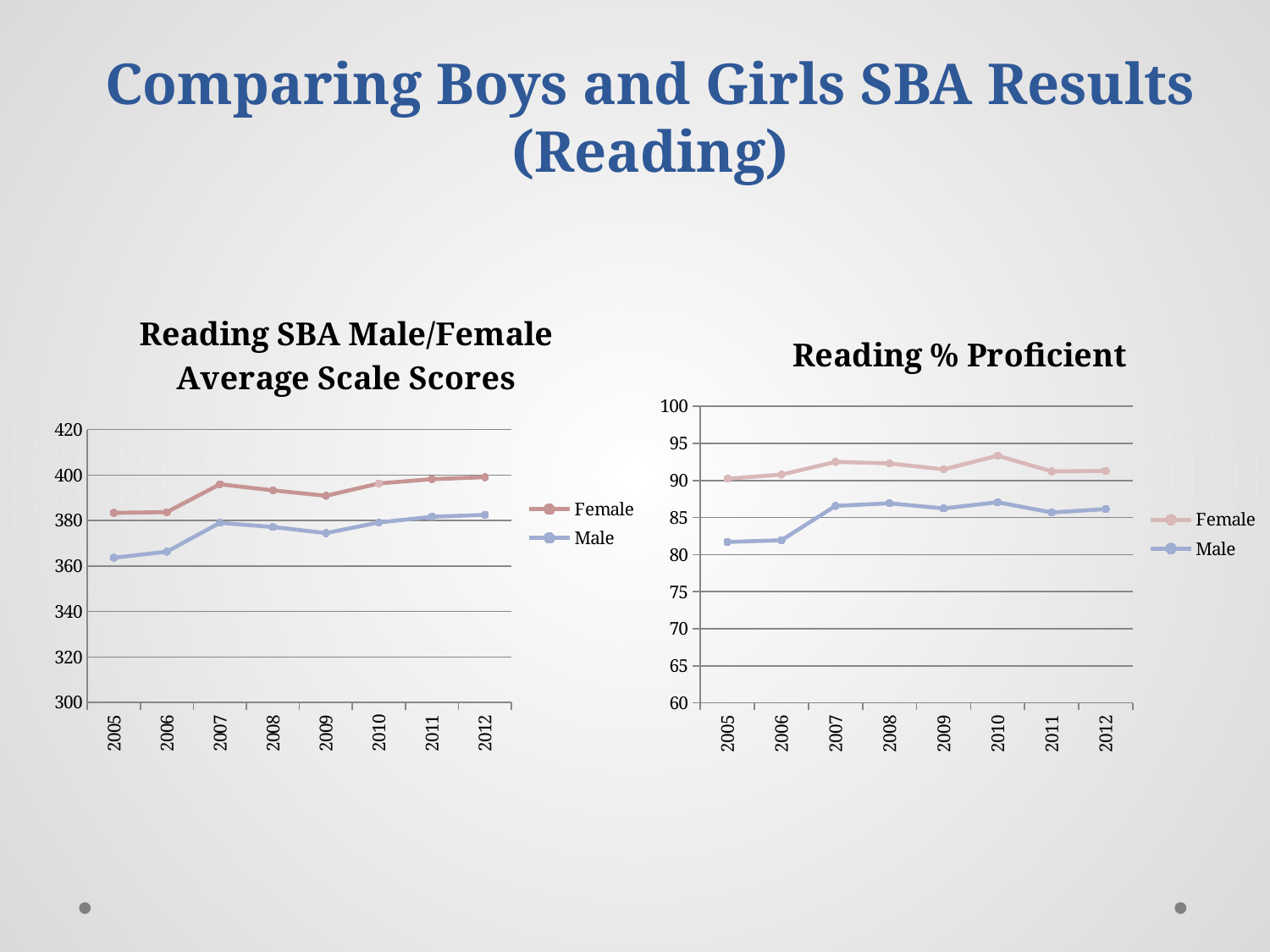
What kind of chart is the 'Reading SBA Male/Female Average Scale Scores' chart on the left? line chart How many years are plotted along the x axis of the 'Reading SBA Male/Female Average Scale Scores' chart? 8 In the 'Reading % Proficient' chart, is the Male value for 2005 greater or less than 85? less How many series does the legend of the 'Reading SBA Male/Female Average Scale Scores' chart list? 2 In the 'Reading % Proficient' chart, in which year is the Female value highest? 2010 In the 'Reading SBA Male/Female Average Scale Scores' chart, is the Male value for 2005 greater or less than 380? less In the 'Reading SBA Male/Female Average Scale Scores' chart, in which year is the Male value lowest? 2005 In the 'Reading SBA Male/Female Average Scale Scores' chart, which series has the higher value in 2009, Female or Male? Female In the 'Reading % Proficient' chart, does the Male line rise or fall from 2005 to 2007? rise What are the two legend entries in the 'Reading % Proficient' chart? Female and Male In the 'Reading SBA Male/Female Average Scale Scores' chart, is the Female value for 2012 greater or less than 380? greater